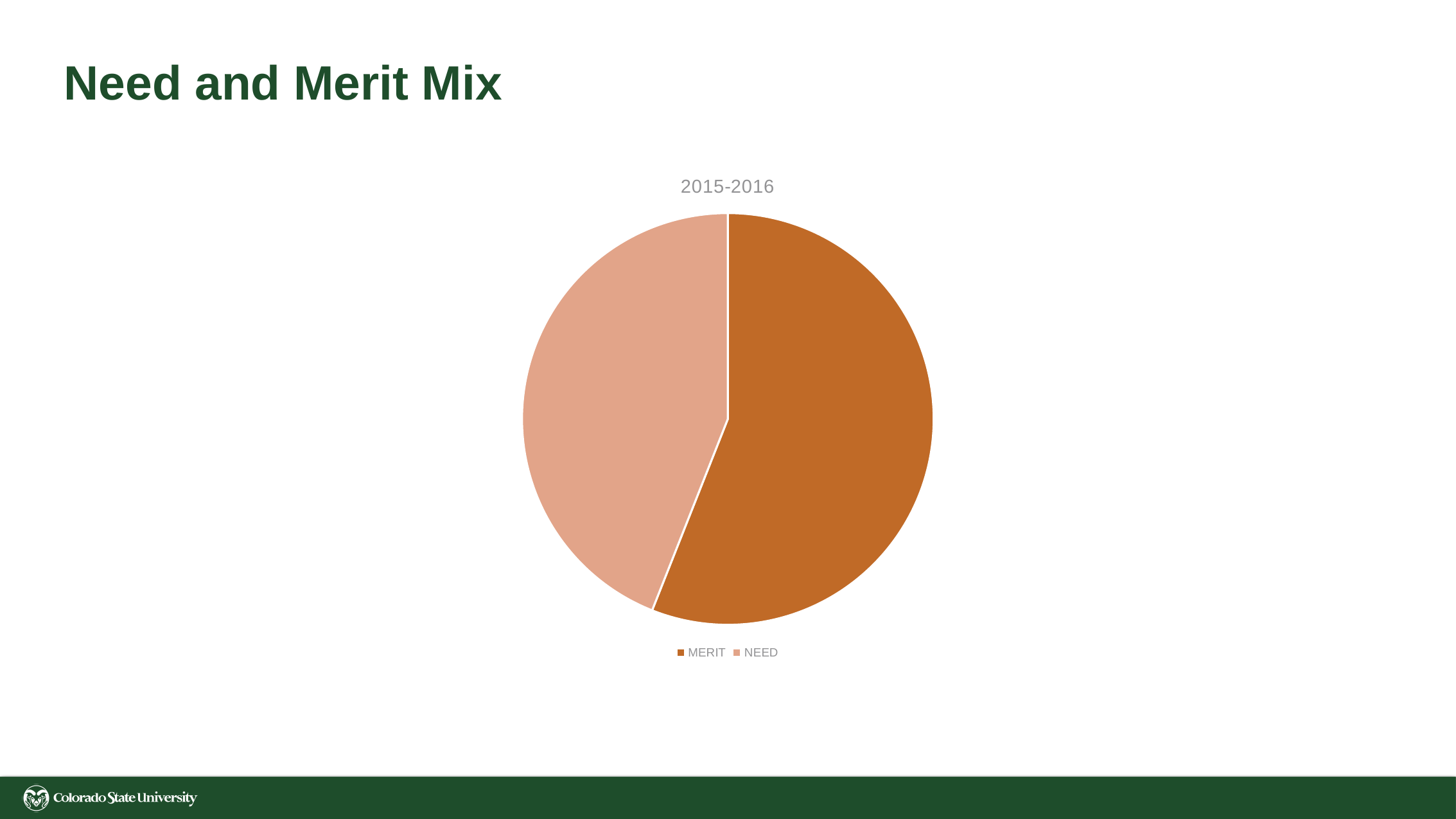
Which slice is larger, MERIT or NEED? MERIT Which legend entry is shown in the lighter shade of orange? NEED How many entries does the legend list? 2 Which category has the smallest slice of the pie? NEED What kind of chart is shown on the slide? pie chart How many slices does the pie chart have? 2 Which category has the largest slice of the pie? MERIT What is the title of the chart? 2015-2016 Does the MERIT slice take up more or less than half of the pie? more